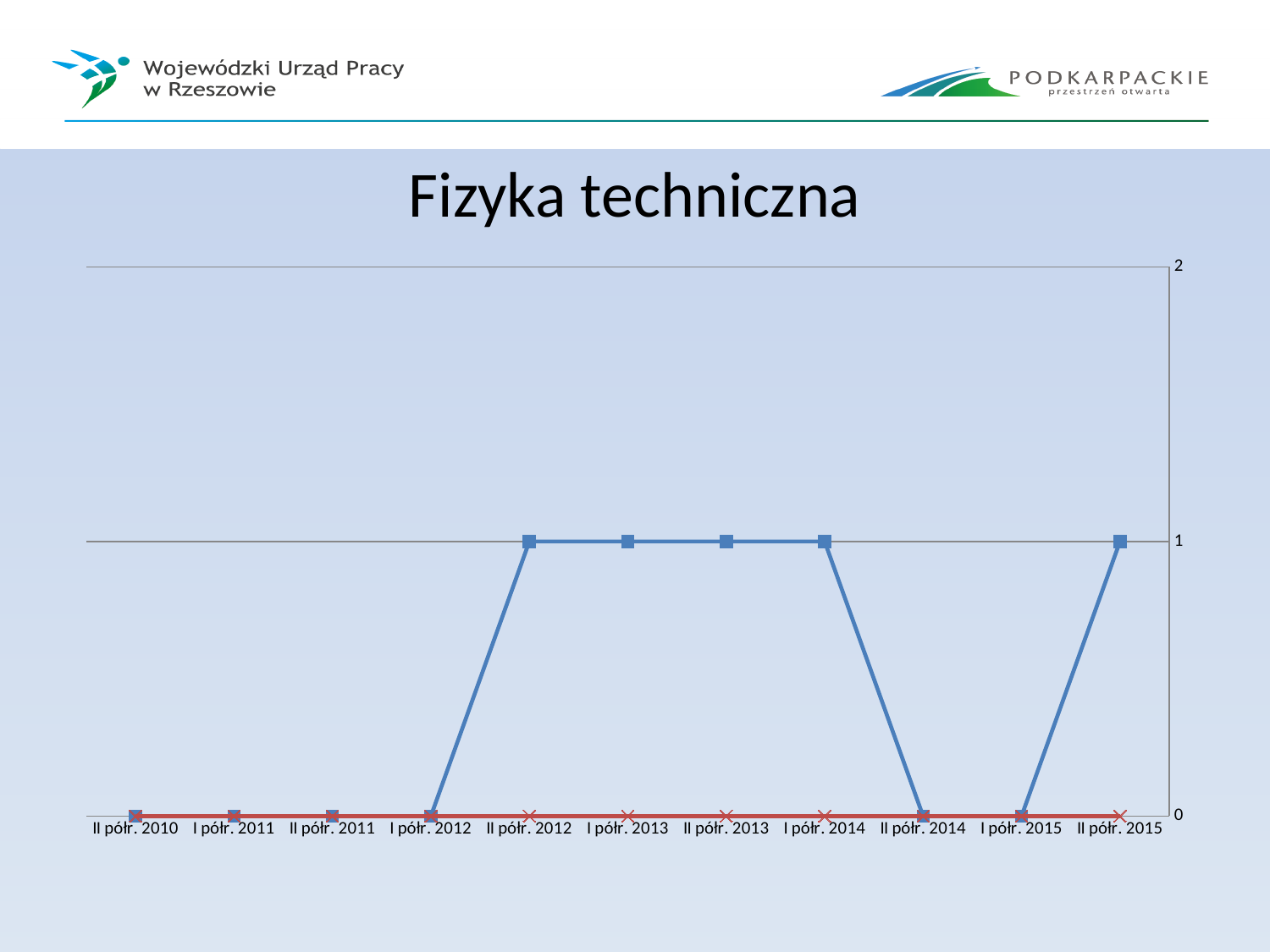
What is the value of the blue line for I półr. 2011? 0 What kind of chart is shown on the slide? line chart Does the blue line rise or fall between I półr. 2014 and II półr. 2014? fall What is the value of the red line for I półr. 2013? 0 What is the value of the blue line for II półr. 2012? 1 How many categories are shown on the x axis? 11 Which is larger for I półr. 2014: the blue line's value or the red line's value? the blue line What is the value of the blue line for II półr. 2014? 0 What is the value of the blue line for II półr. 2015? 1 What is the difference between the blue line's value for I półr. 2013 and its value for I półr. 2015? 1 What is the highest value reached by the blue line? 1 What is the title of the chart? Fizyka techniczna